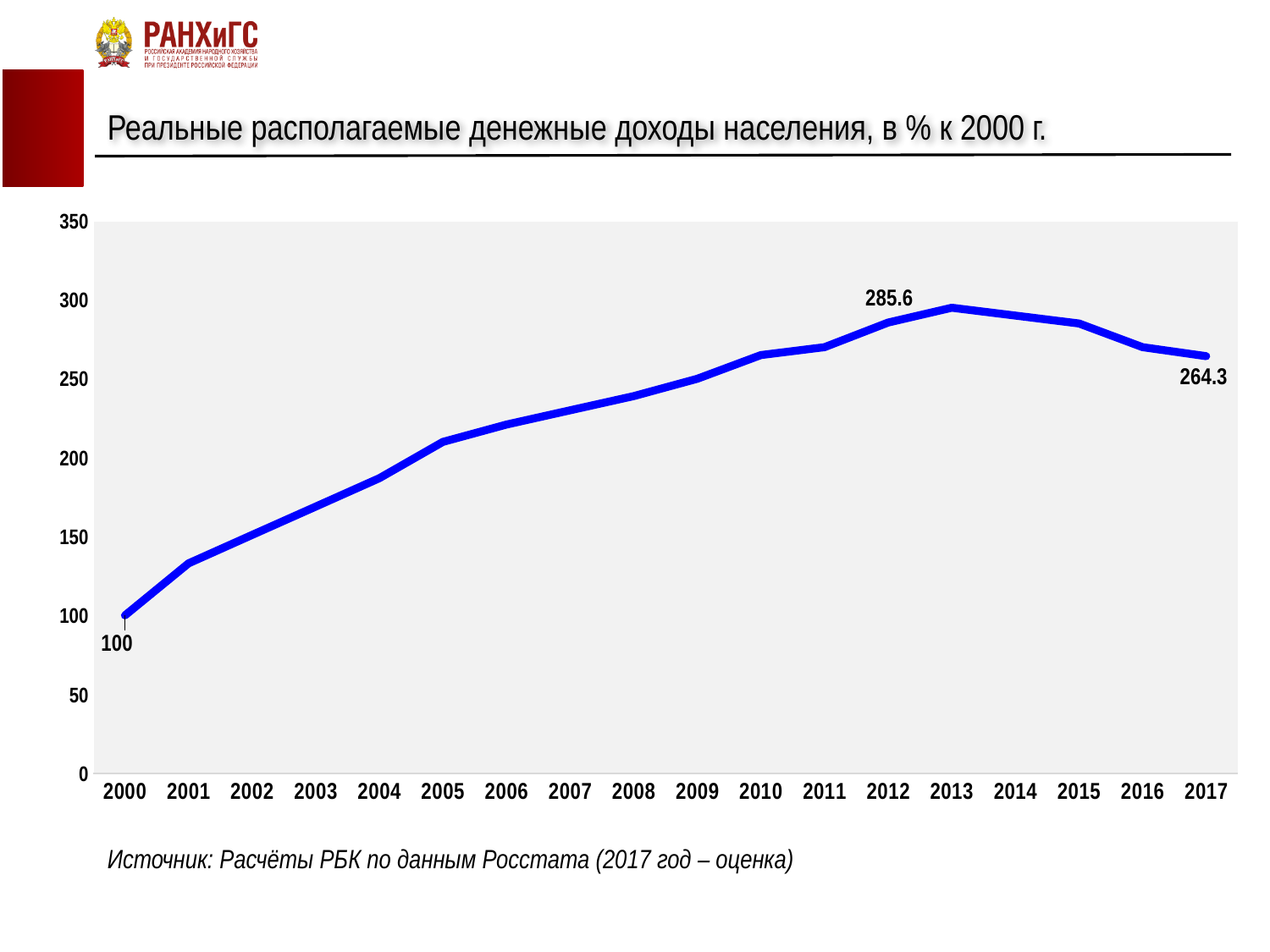
What is the value for 2017? 264.3 What is the value for 2000? 100 What is the value labelled for 2012? 285.6 Which year has the highest value? 2013 Is the value for 2008 greater or less than 250? less Which year has the lowest value? 2000 Is the value for 2001 greater or less than 150? less What type of chart is shown on the slide? line chart Is the value for 2005 greater or less than 200? greater What is the difference between the value for 2012 (285.6) and the value for 2017 (264.3)? 21.3 Does the line rise or fall between 2013 and 2017? fall How many years are plotted on the x axis? 18